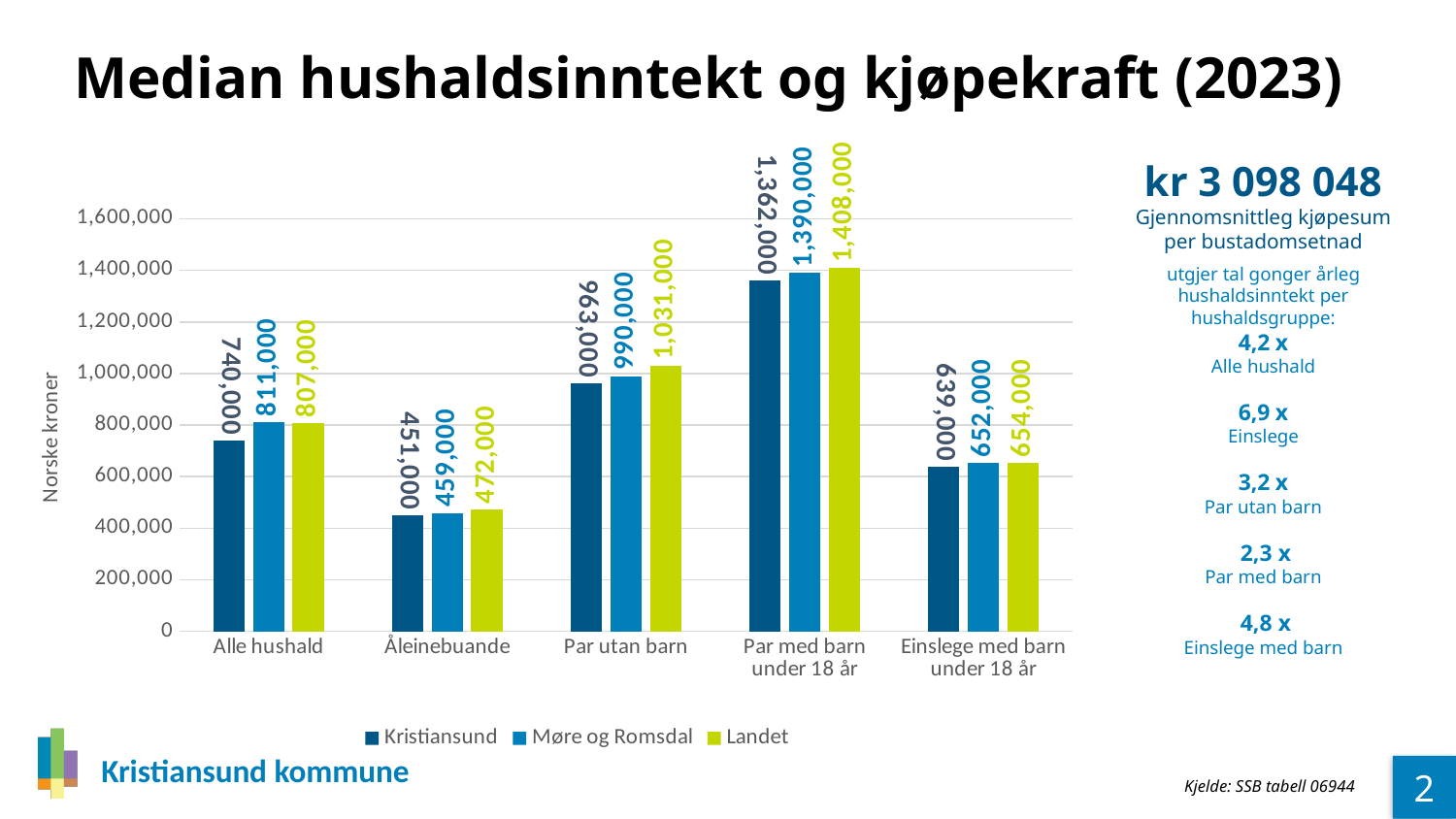
Is the value for Kristiansund in Par utan barn greater or less than 1,000,000? less How many household categories are shown on the x axis? 5 What is the value for Møre og Romsdal in the category Par med barn under 18 år? 1,390,000 What is the median household income for Kristiansund in the category Alle hushald? 740,000 What kind of chart is shown on the slide? Bar chart Which category has the highest value for Landet? Par med barn under 18 år What is the difference between the Landet and Kristiansund values for Alle hushald? 67,000 Which is larger for Åleinebuande: the value for Møre og Romsdal or the value for Landet? Landet What is the value for Landet in the category Par utan barn? 1,031,000 How many series does the legend list? 3 What is the value for Kristiansund in the category Einslege med barn under 18 år? 639,000 Which category has the lowest value for Kristiansund? Åleinebuande